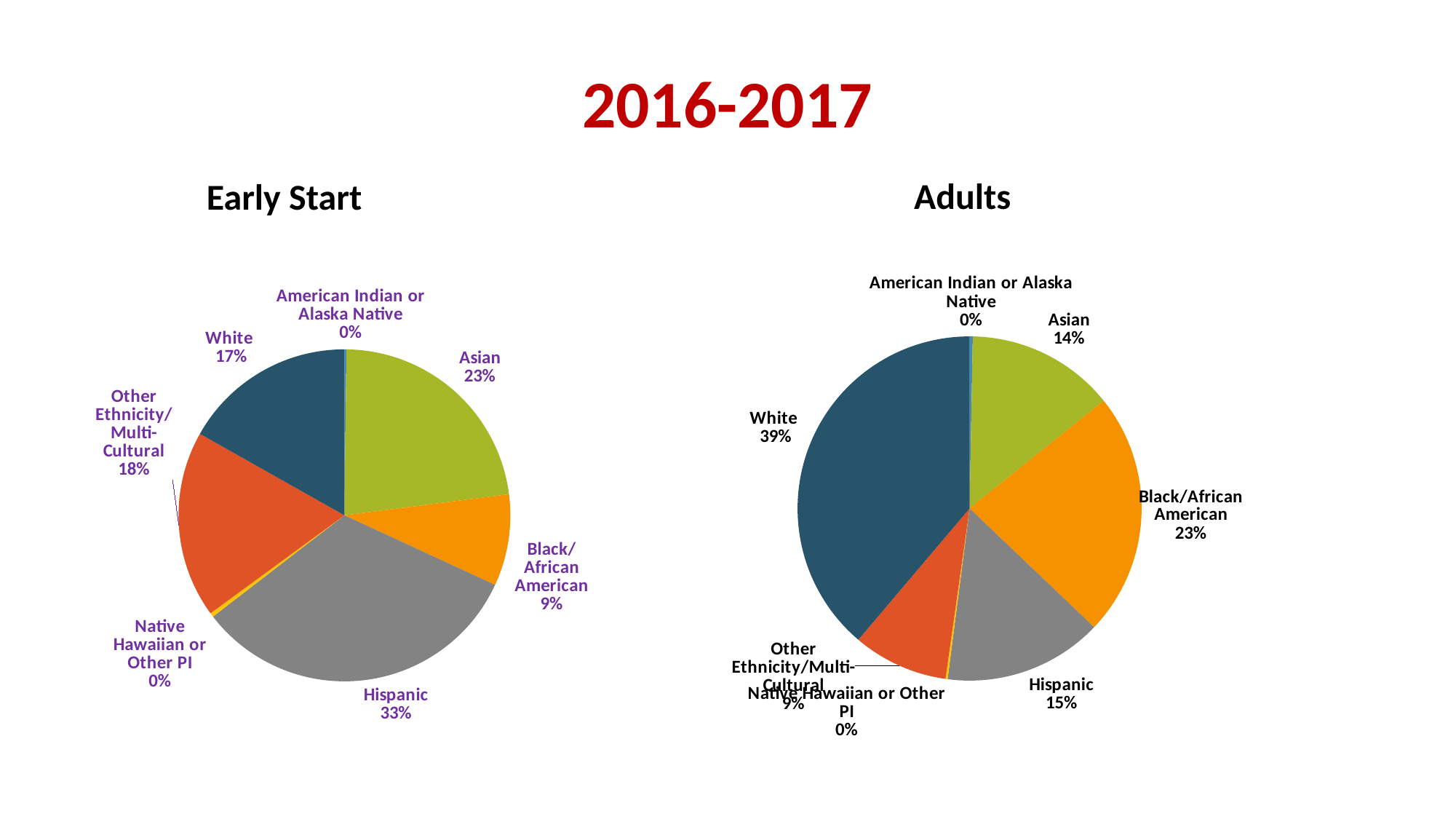
What kind of chart is the Adults chart? Pie chart In the Early Start chart, what is the difference between the Hispanic share and the White share? 16% In the Adults chart, what is the difference between the White share and the Hispanic share? 24% How many categories are shown in the Early Start chart? 7 In the Early Start chart, what share is Hispanic? 33% In the Adults chart, what share is White? 39% In the Early Start chart, which is larger, the Other Ethnicity/Multi-Cultural share or the Black/African American share? Other Ethnicity/Multi-Cultural In the Early Start chart, what share is Asian? 23% In the Early Start chart, which category has the largest share? Hispanic In the Adults chart, which is larger, the Asian share or the Black/African American share? Black/African American In the Adults chart, which category has the largest share? White In the Adults chart, what share is Black/African American? 23%